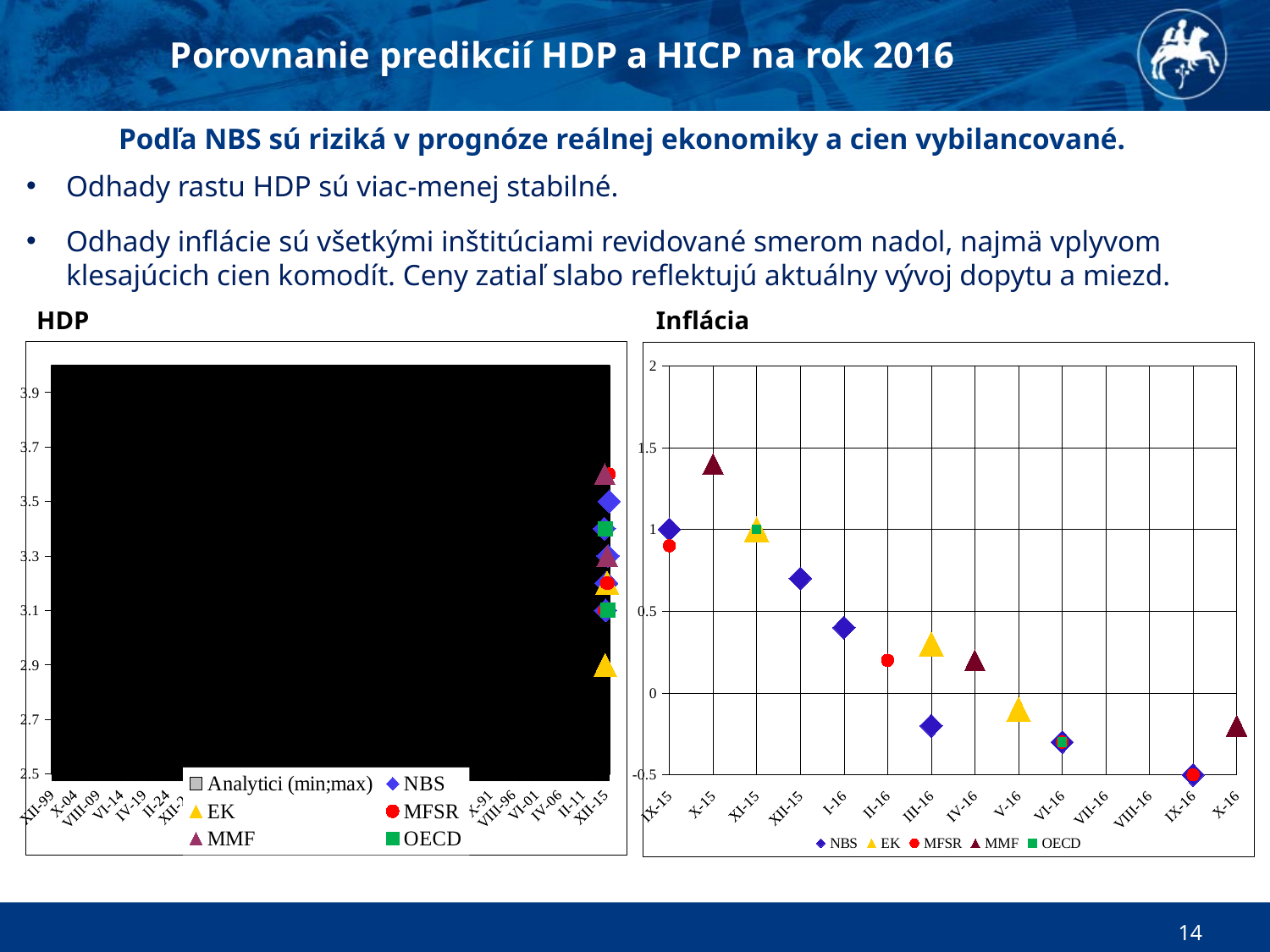
On the Inflácia chart, which is larger: the MMF value at X-15 or the MMF value at IV-16? MMF at X-15 On the Inflácia chart, is the MMF value at X-15 greater or less than 1? greater On the Inflácia chart, how many date labels are shown on the x axis? 14 On the Inflácia chart, do the NBS values rise or fall from IX-15 to IX-16? fall On the HDP chart, how many entries does the legend list? 6 On the Inflácia chart, is the NBS value at III-16 greater or less than 0? less What kind of chart is the Inflácia chart? scatter chart On the Inflácia chart, which series has the highest plotted value? MMF On the Inflácia chart, how many series does the legend list? 5 On the Inflácia chart, is the NBS value at XII-15 greater or less than 0.5? greater On the Inflácia chart, what is the NBS value at IX-15? 1